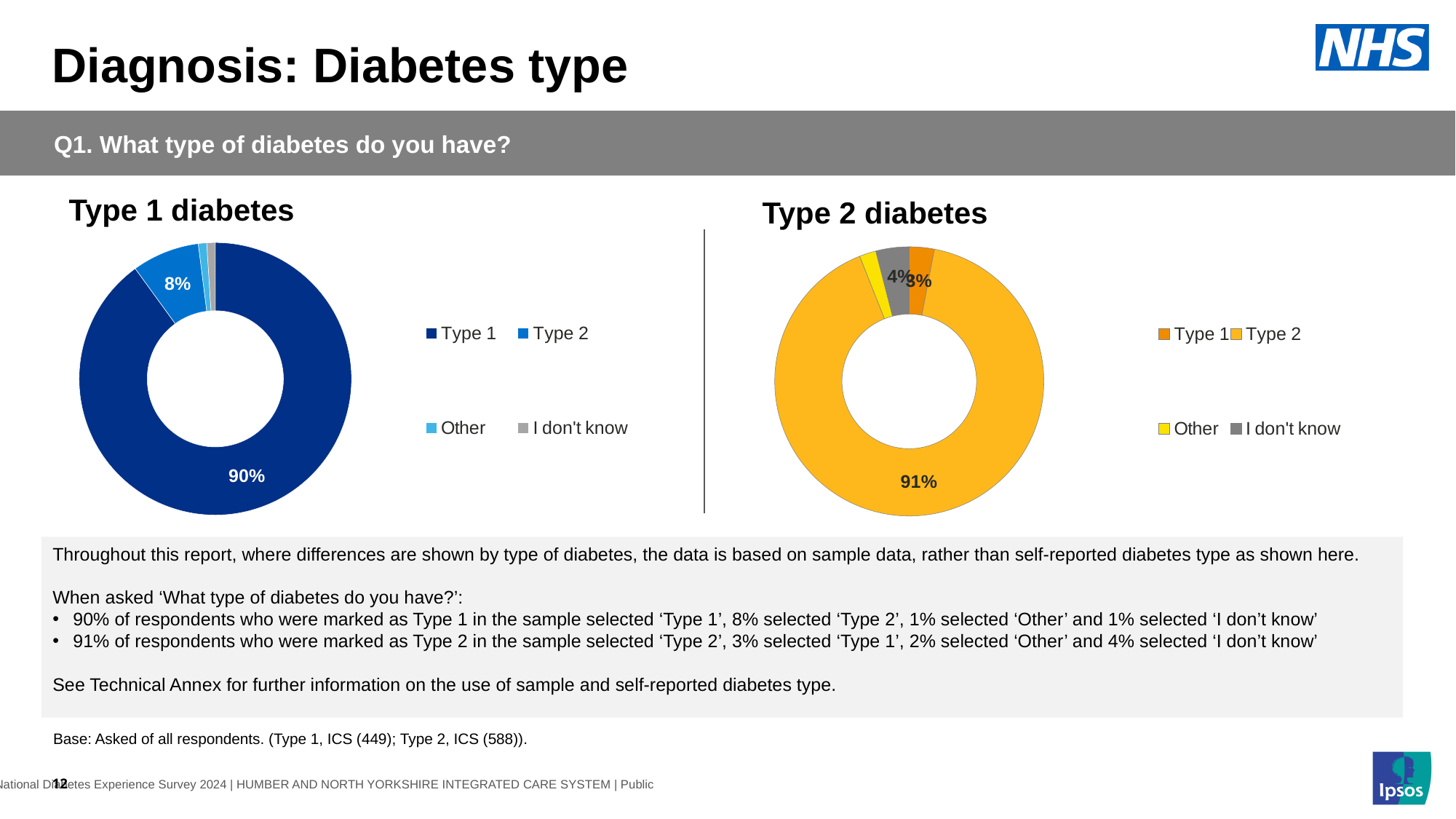
In the Type 2 diabetes chart, what percentage of respondents selected 'Type 1'? 3% What colour represents 'Other' in the Type 2 diabetes chart? Yellow In the Type 2 diabetes chart, which category has the largest share? Type 2 What kind of chart is used for the Type 2 diabetes data? Doughnut (pie) chart In the Type 2 diabetes chart, what percentage of respondents selected 'I don't know'? 4% In the Type 1 diabetes chart, what percentage of respondents selected 'Type 2'? 8% In the Type 2 diabetes chart, what percentage of respondents selected 'Type 2'? 91% In the Type 1 diabetes chart, which category has the largest share? Type 1 In the Type 1 diabetes chart, what is the difference between the 'Type 1' and 'Type 2' shares? 82 percentage points In the Type 1 diabetes chart, what percentage of respondents selected 'Type 1'? 90% How many categories does the legend of the Type 1 diabetes chart list? 4 Which is larger: the 'Type 1' share in the Type 1 diabetes chart or the 'Type 2' share in the Type 2 diabetes chart? The 'Type 2' share in the Type 2 diabetes chart (91%)